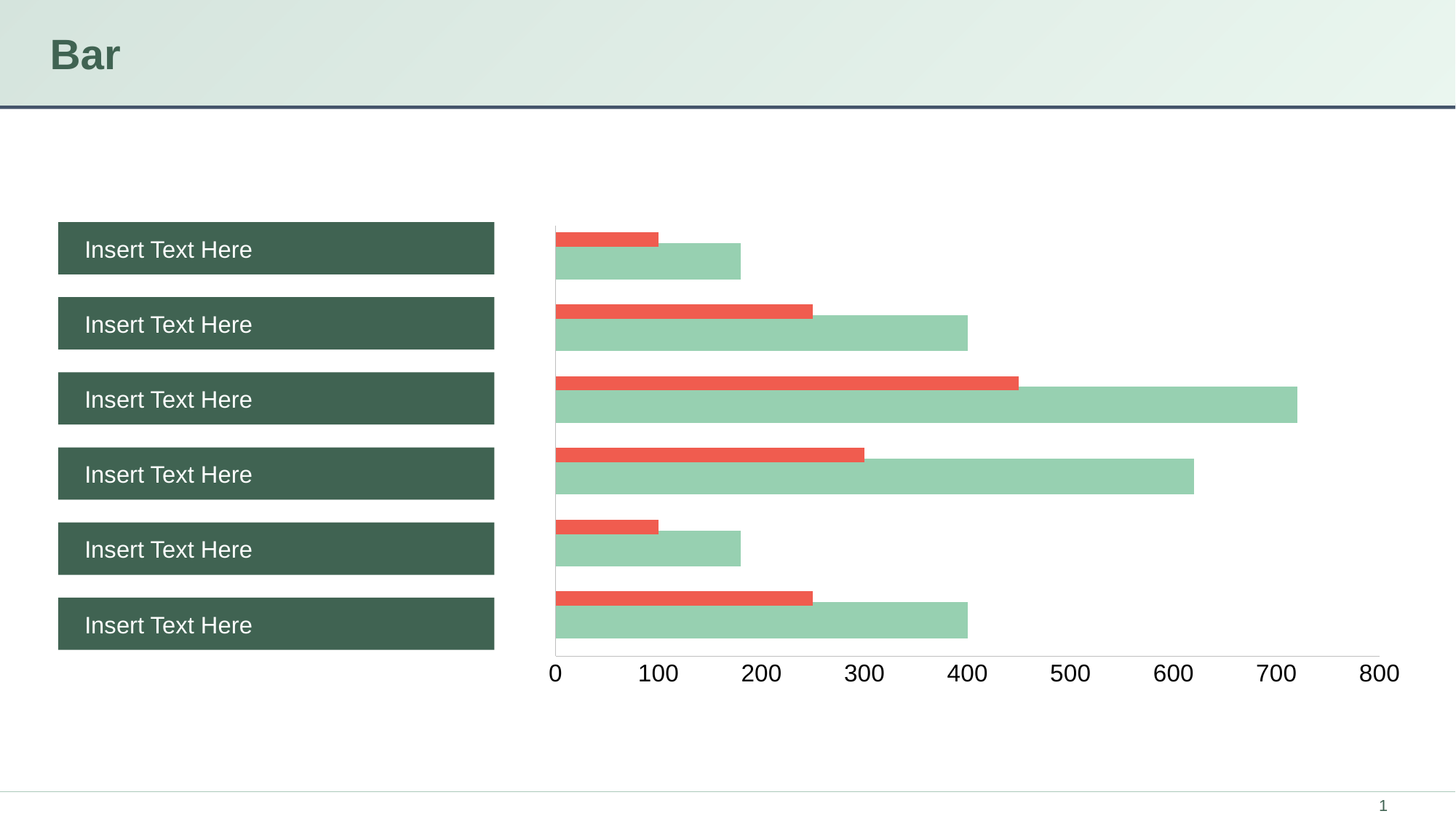
Is the green bar in the top row greater or less than 200? less How many categories (rows) does the bar chart have? 6 Which row has the longest bar in the chart? the third row from the top What two colours are used for the bars in the chart? red and light green Is the green bar in the fourth row from the top greater or less than 600? greater What is the value of the red bar in the top row of the chart? 100 What is the difference between the red bar in the fourth row (300) and the red bar in the top row (100)? 200 Which is larger: the red bar in the third row or the red bar in the fourth row? the red bar in the third row What is the value of the green bar in the second row from the top? 400 What kind of chart is shown on the slide? bar chart What is the value of the red bar in the fourth row from the top? 300 Is the green bar in the third row from the top greater or less than 700? greater